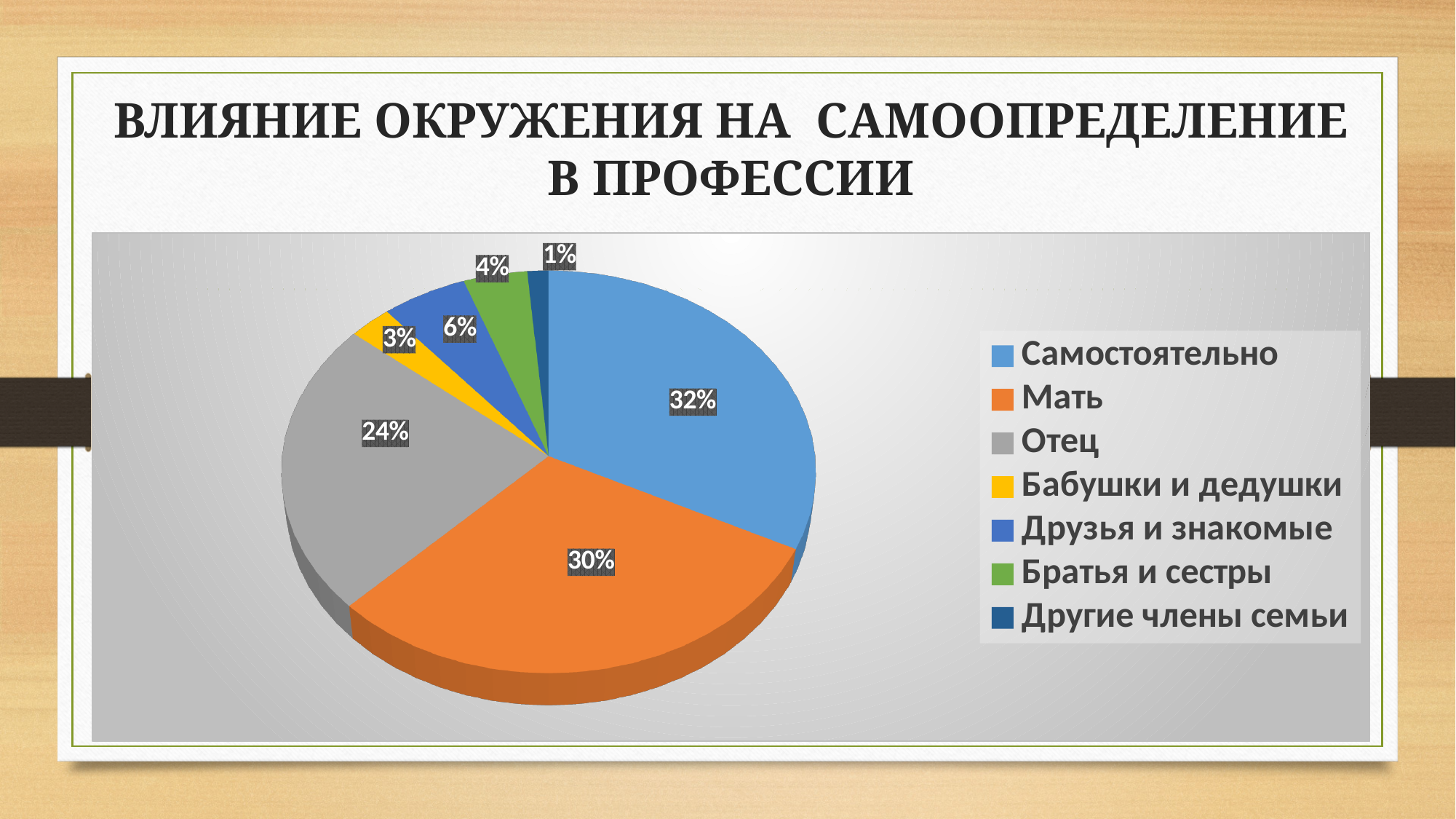
What is the value for Друзья и знакомые? 6% What is the difference between the values for Мать and Отец? 6% Which category has the smallest slice? Другие члены семьи What is the value for Бабушки и дедушки? 3% What is the value for Отец? 24% What share of the pie does Самостоятельно have? 32% What kind of chart is shown on the slide? pie chart How many categories does the legend list? 7 What is the value for Другие члены семьи? 1% Which category has the largest slice? Самостоятельно What is the value for Мать? 30% Which is larger, Друзья и знакомые or Братья и сестры? Друзья и знакомые